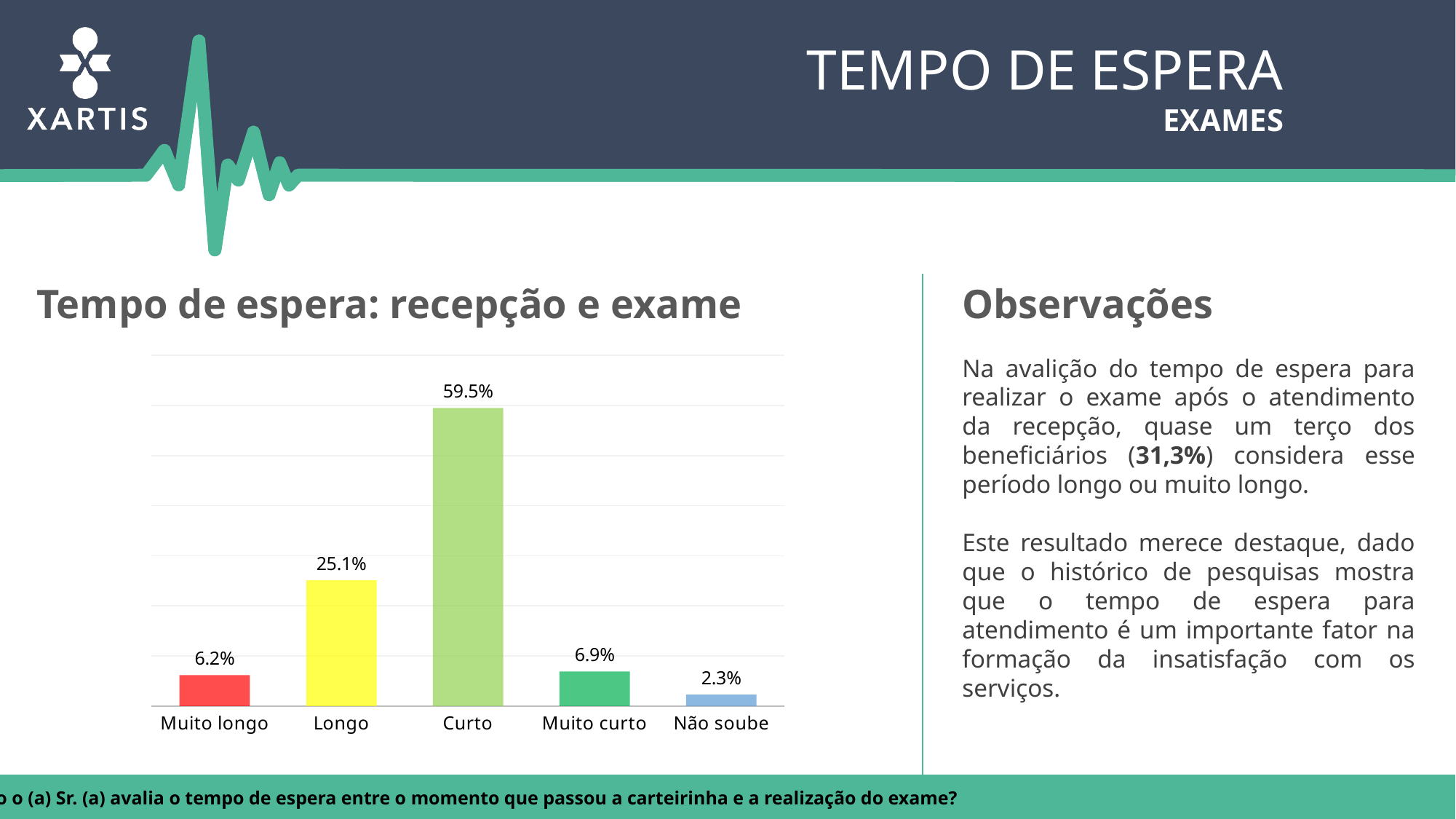
What is the value for 'Muito longo' in the chart? 6.2% What is the difference between the values for 'Muito curto' and 'Muito longo'? 0.7% What kind of chart is shown on the slide? Bar chart Which category has the lowest value in the chart? Não soube Which category has the highest value in the chart? Curto Which is larger: the value for 'Muito curto' or the value for 'Muito longo'? Muito curto What is the value for 'Curto' in the chart? 59.5% How many categories are shown in the chart? 5 What is the value for 'Longo' in the chart? 25.1% What is the title of the chart on the slide? Tempo de espera: recepção e exame What is the difference between the values for 'Curto' and 'Longo'? 34.4% What is the value for 'Não soube' in the chart? 2.3%